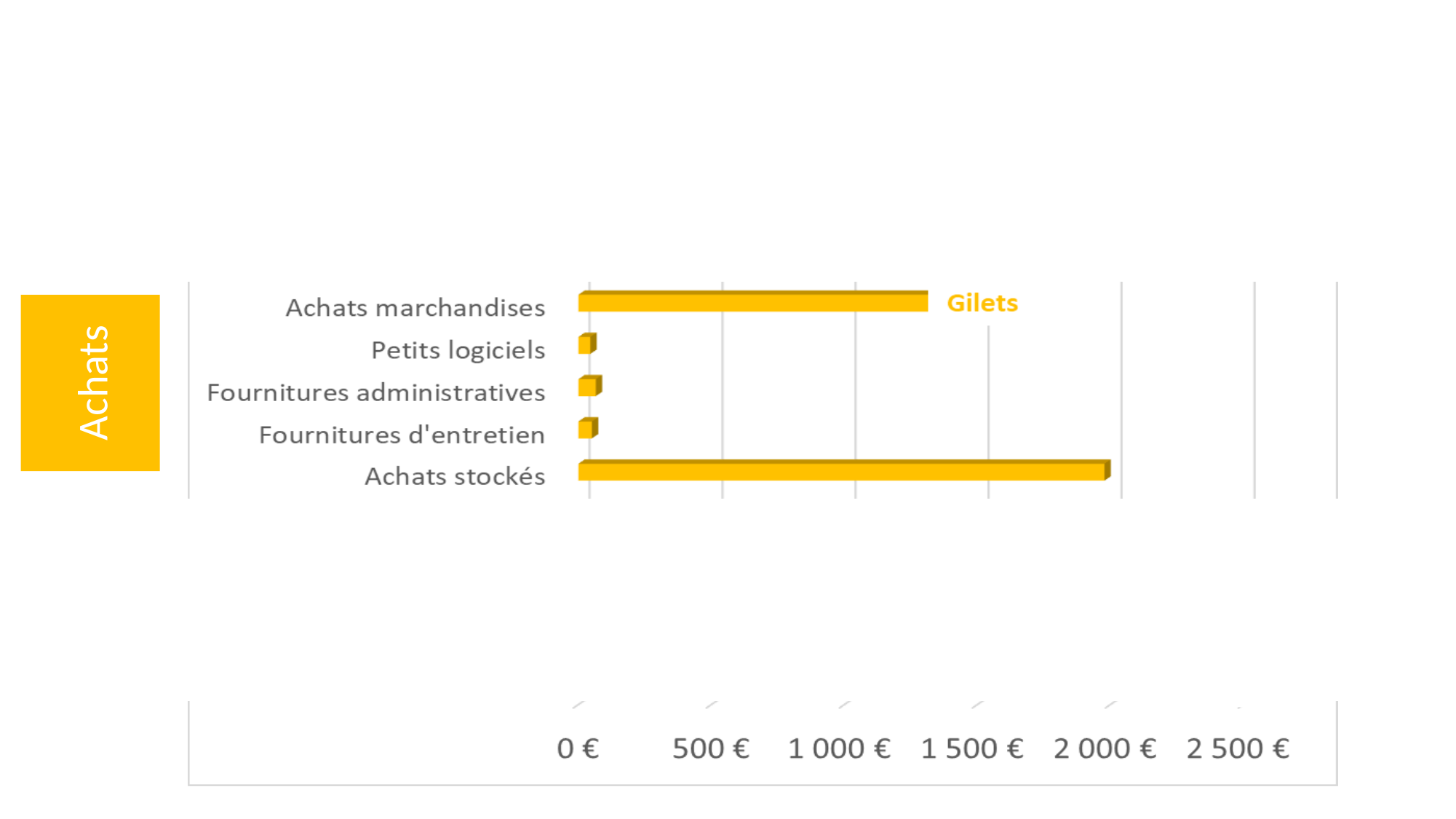
What annotation text is written next to the Achats marchandises bar? Gilets Is the value for Fournitures administratives greater or less than 500 €? less Is the value for Achats stockés greater or less than 1 500 €? greater Which is larger, the value for Achats stockés or the value for Achats marchandises? Achats stockés Is the value for Petits logiciels greater or less than 500 €? less Which is larger, the value for Achats marchandises or the value for Petits logiciels? Achats marchandises How many categories are plotted in the chart? 5 What word appears in the vertical label box to the left of the chart? Achats Which category has the highest value in the chart? Achats stockés What kind of chart is shown on the slide? bar chart